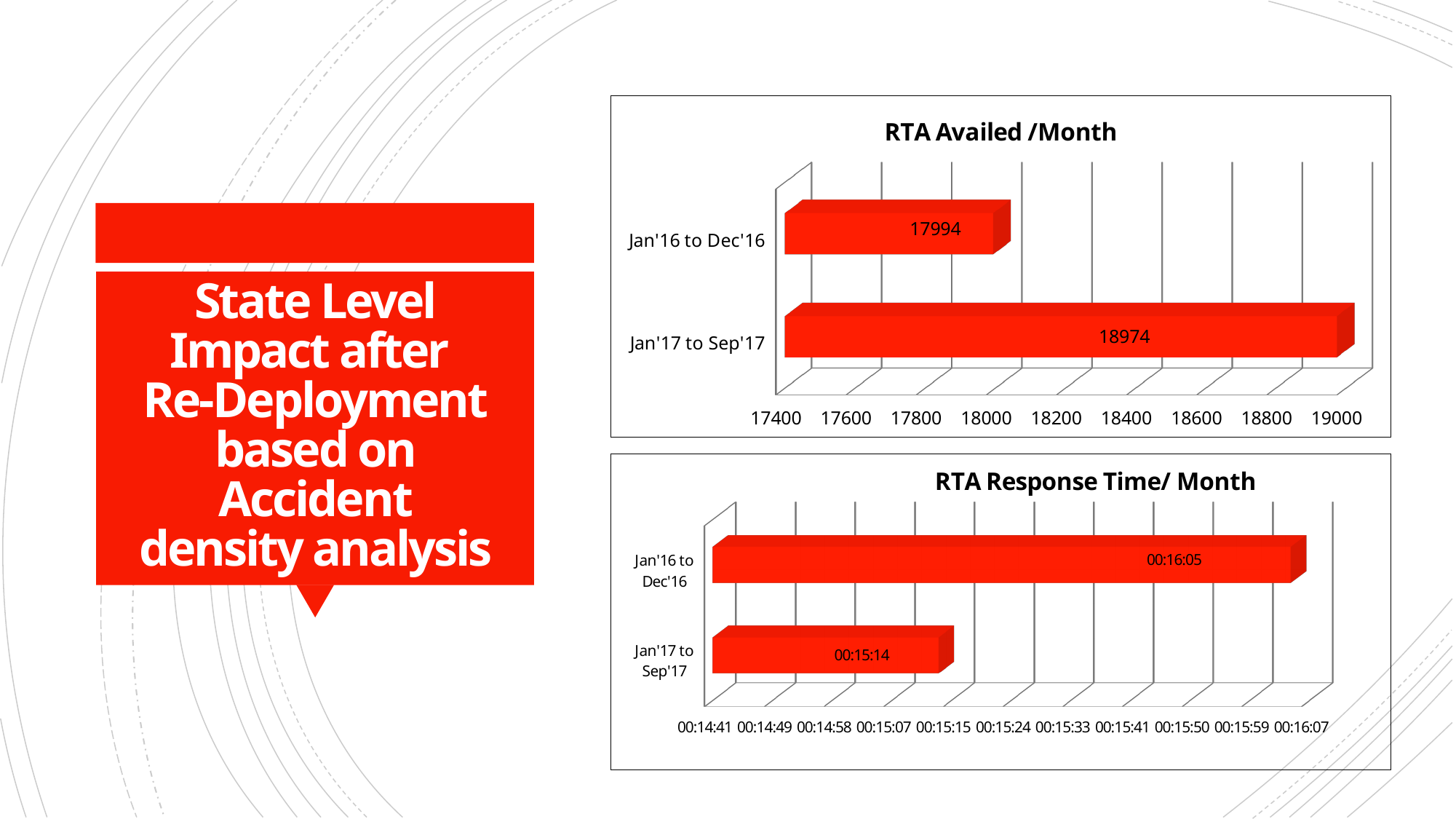
In the 'RTA Availed /Month' chart, what is the difference between the Jan'17 to Sep'17 value and the Jan'16 to Dec'16 value? 980 In the 'RTA Availed /Month' chart, which period has the higher value? Jan'17 to Sep'17 In the 'RTA Response Time/ Month' chart, which period has the lower response time? Jan'17 to Sep'17 In the 'RTA Availed /Month' chart, what is the value for Jan'17 to Sep'17? 18974 In the 'RTA Availed /Month' chart, is the value for Jan'17 to Sep'17 greater or less than 18800? greater In the 'RTA Availed /Month' chart, what is the value for Jan'16 to Dec'16? 17994 In the 'RTA Response Time/ Month' chart, by how many seconds does the Jan'16 to Dec'16 response time exceed the Jan'17 to Sep'17 response time? 51 seconds In the 'RTA Response Time/ Month' chart, what is the value for Jan'16 to Dec'16? 00:16:05 In the 'RTA Response Time/ Month' chart, what is the value for Jan'17 to Sep'17? 00:15:14 How many categories are shown in the 'RTA Availed /Month' chart? 2 In the 'RTA Response Time/ Month' chart, is the response time for Jan'16 to Dec'16 larger or smaller than for Jan'17 to Sep'17? larger What kind of chart is the 'RTA Response Time/ Month' chart? Bar chart